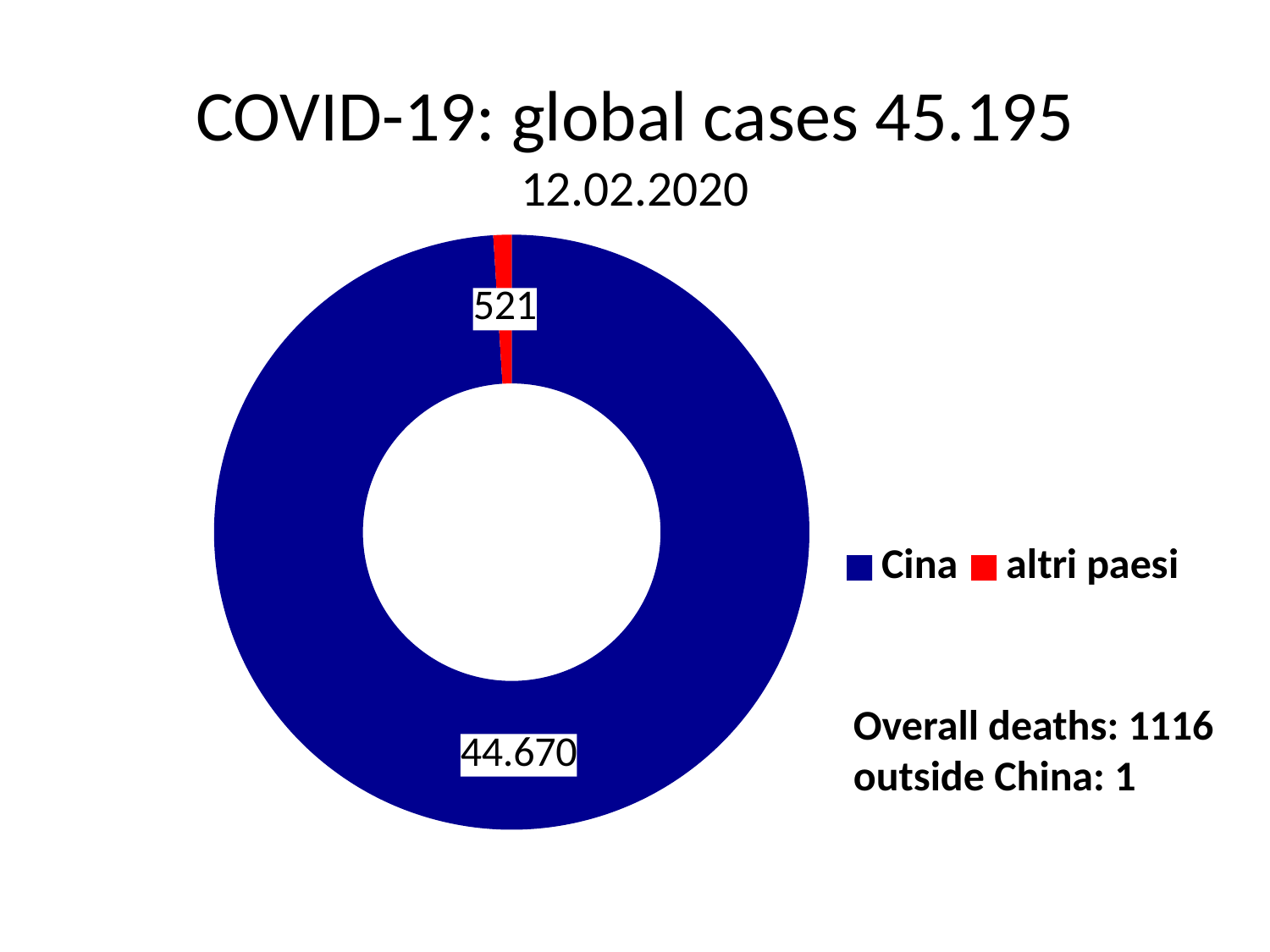
How many categories are shown in the chart? 2 What kind of chart is shown on the slide? Pie chart (doughnut) Which category has the largest slice of the chart? Cina What is the difference between the value for Cina and the value for altri paesi? 44.149 How many entries does the legend list? 2 Which is larger, the value for Cina or the value for altri paesi? Cina What is the title of the chart? COVID-19: global cases 45.195 What colour represents Cina in the chart? Blue What value is shown for Cina on the chart? 44.670 What value is shown for altri paesi on the chart? 521 Which category has the smallest slice of the chart? altri paesi